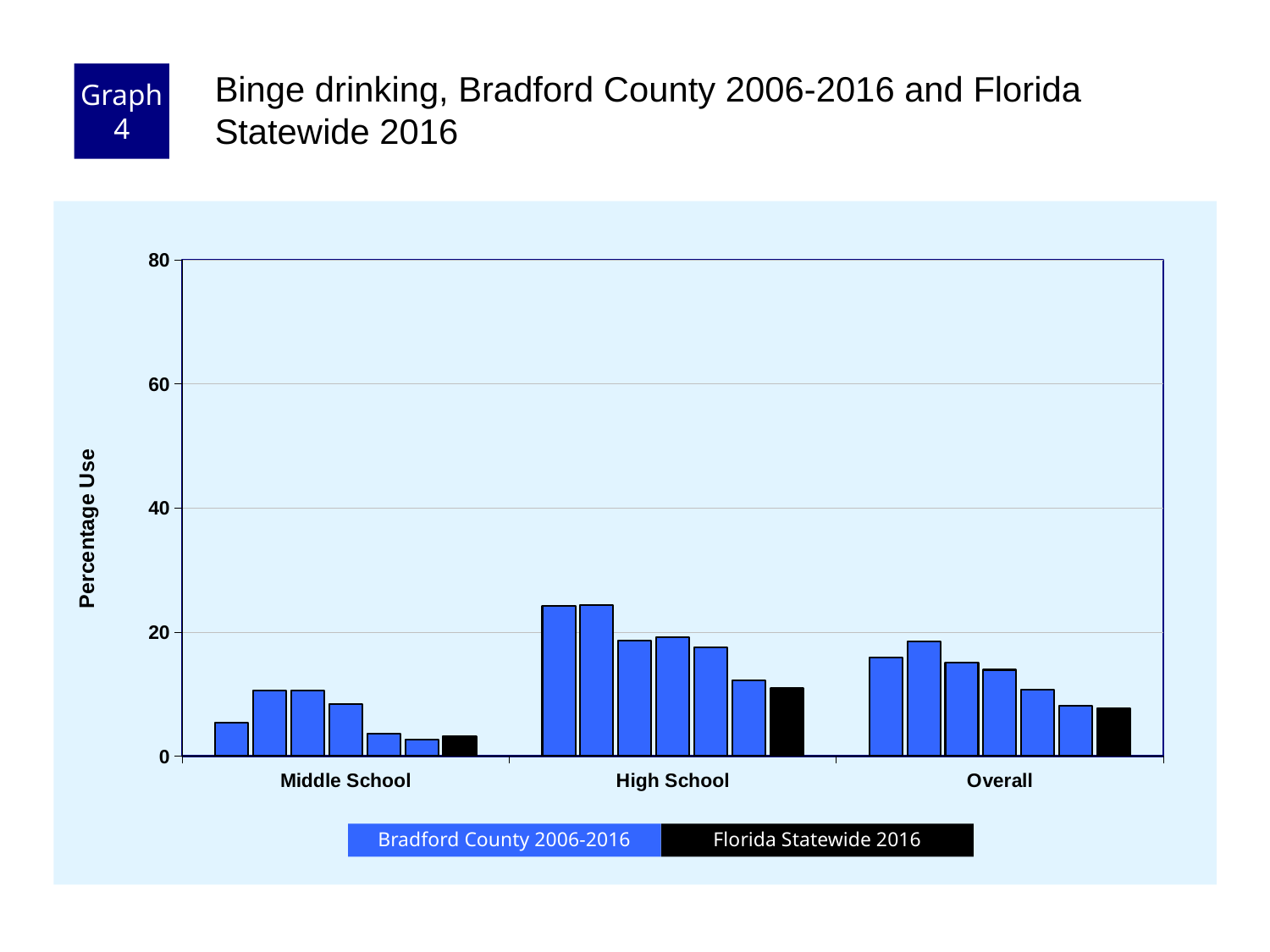
How many categories are shown on the x axis? 3 Within the High School group, do the Bradford County 2006-2016 bars generally rise or fall from left to right? fall Which colour represents Florida Statewide 2016 in the legend? black Which is larger, the Florida Statewide 2016 value for High School or for Middle School? High School What kind of chart is shown on the slide? bar chart Is the Florida Statewide 2016 value for Overall greater or less than 20? less Which category has the lowest Florida Statewide 2016 value? Middle School Is the Florida Statewide 2016 value for High School greater or less than 20? less Which category has the highest Florida Statewide 2016 value? High School How many series does the legend list? 2 Is the tallest Bradford County 2006-2016 bar for High School greater or less than 20? greater What is the label on the y axis? Percentage Use